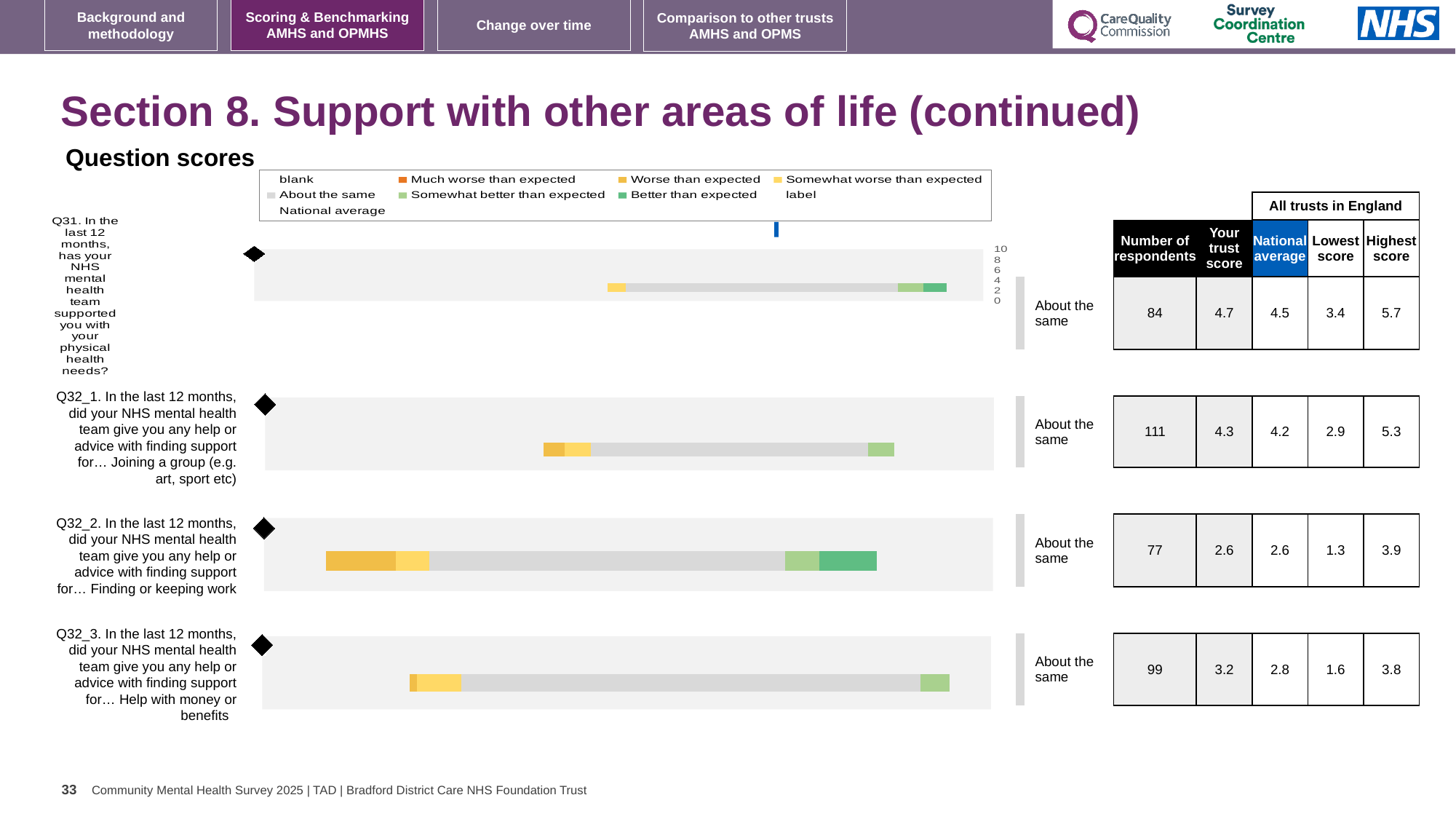
For Q31, which is larger: the trust score or the national average? The trust score What kind of chart is used to show the question scores on this slide? Bar chart What is the national average for Q32_1 (help with joining a group)? 4.2 What benchmark category label is shown next to each of the four bars? About the same Which question has the lowest trust score on this slide? Q32_2 What is the highest score across all trusts in England for Q32_3 (help with money or benefits)? 3.8 How many questions (bars) are shown in the question scores charts on this slide? 4 Which colour does the legend use for 'Much worse than expected'? Orange What is the difference between the trust score and the national average for Q32_3 (help with money or benefits)? 0.4 What is the trust score for Q31 (support with physical health needs)? 4.7 What is the number of respondents for Q32_2 (help with finding or keeping work)? 77 Which question has the highest trust score on this slide? Q31